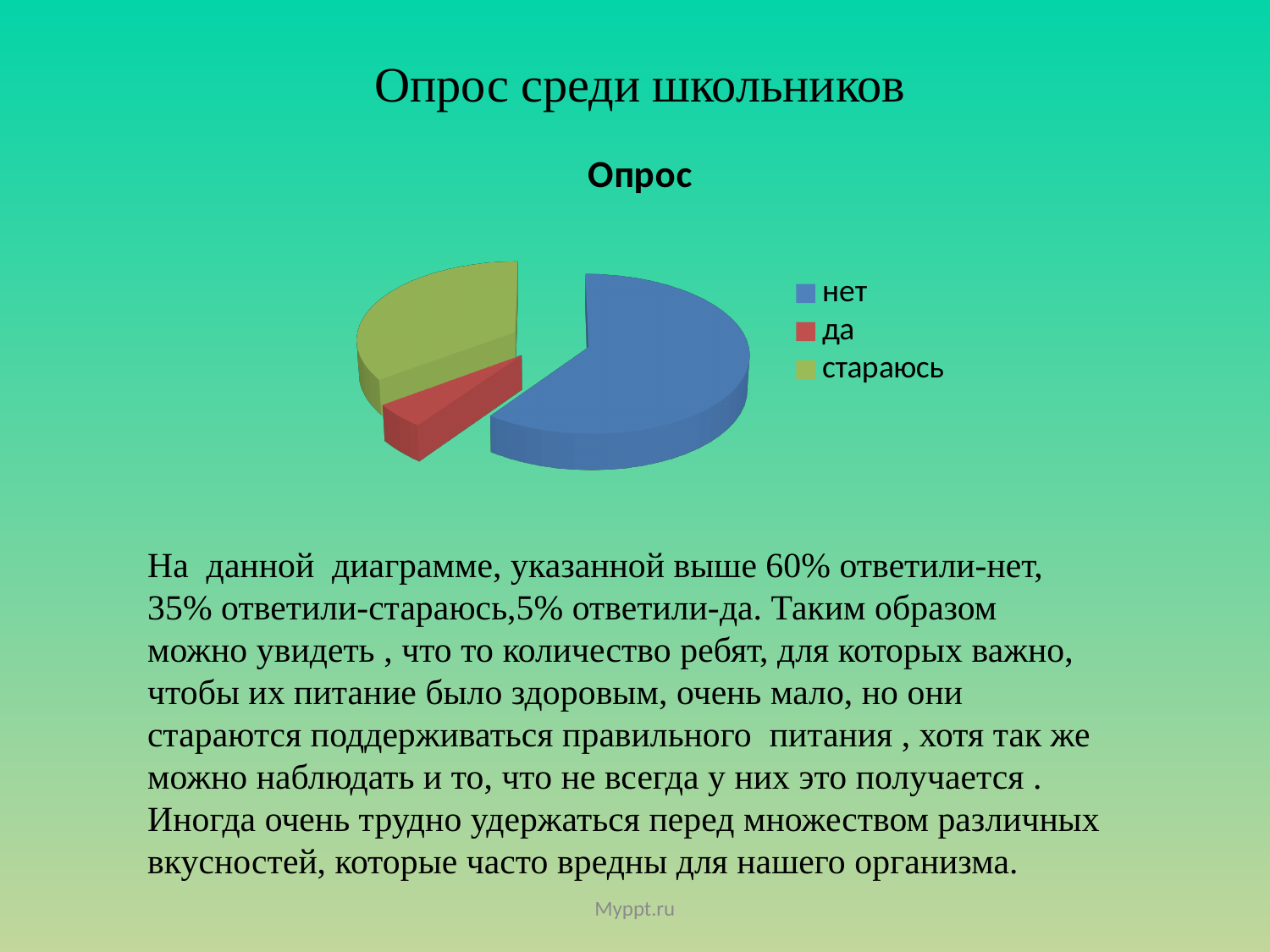
Which category has the largest slice of the pie? нет What kind of chart is shown on the slide? pie chart What colour is the slice for нет? blue Which category has the smallest slice of the pie? да Which slice is larger, нет or стараюсь? нет What is the title of the chart? Опрос According to the slide, what share of respondents answered нет? 60% Which slice is larger, стараюсь or да? стараюсь How many slices does the pie chart have? 3 According to the slide, what share of respondents answered да? 5% According to the slide, what share of respondents answered стараюсь? 35% How many entries does the chart legend list? 3